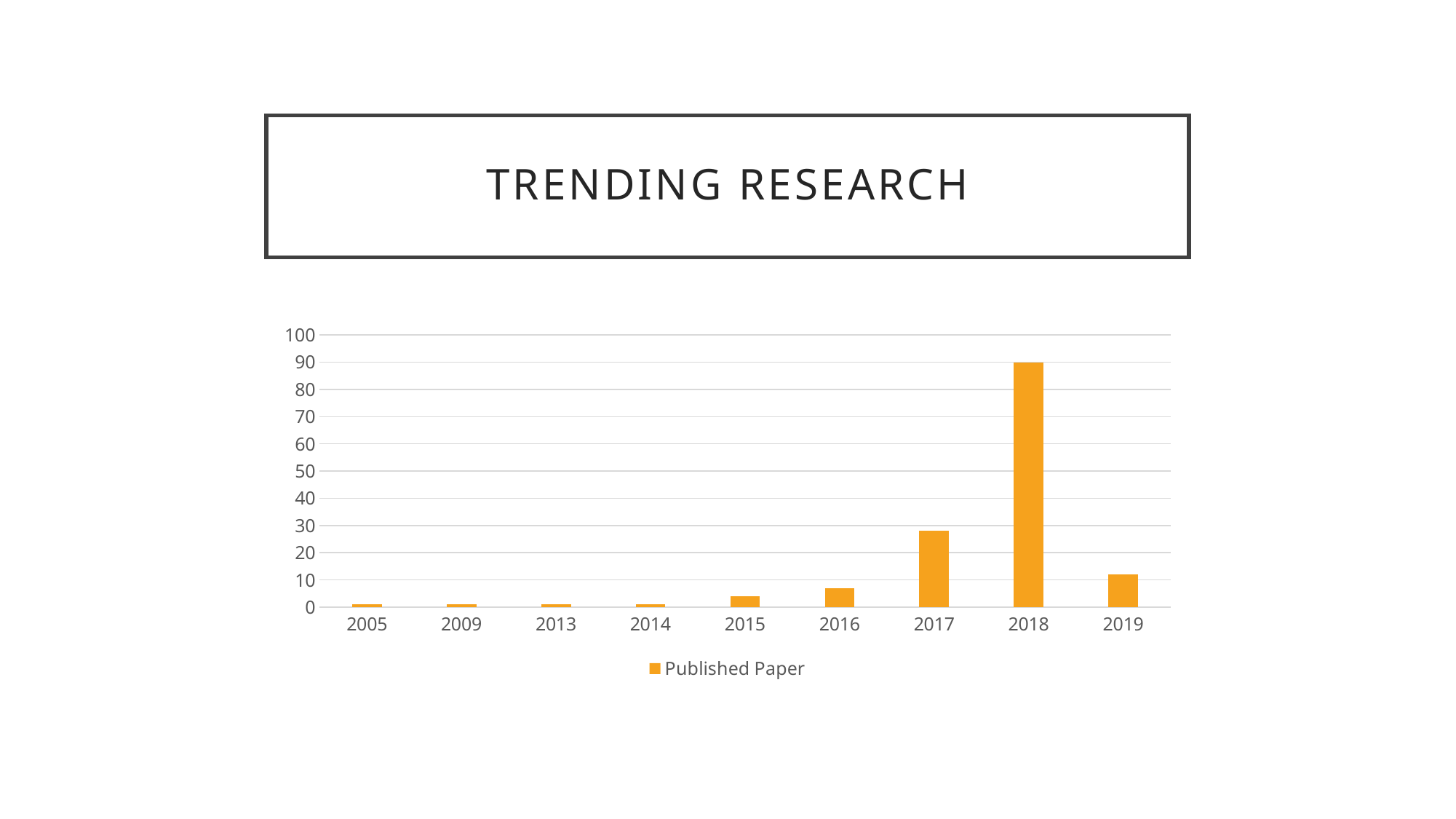
How many series does the legend list? 1 Do the values rise or fall from 2015 to 2018? rise Which year has the highest number of published papers? 2018 Is the value for 2017 greater or less than 20? greater How many years are shown on the x axis of the chart? 9 What kind of chart is shown on the slide? bar chart Is the value for 2016 greater or less than 10? less What is the name of the series shown in the legend? Published Paper Which is larger, the value for 2017 or the value for 2019? 2017 What is the title of the slide containing the chart? TRENDING RESEARCH Is the value for 2019 greater or less than 10? greater What is the value for 2018? 90